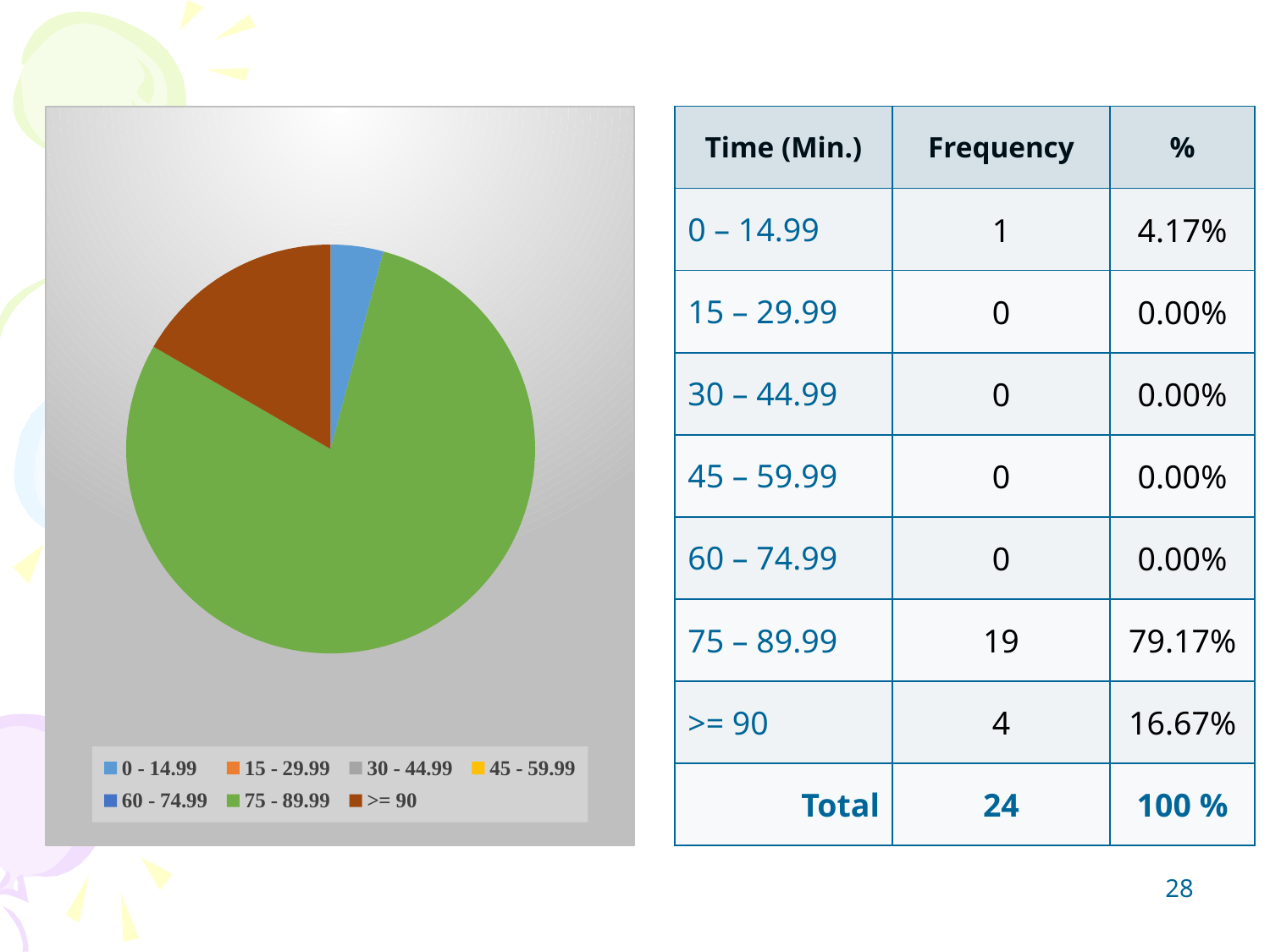
What is the difference in frequency between the 75 – 89.99 and >= 90 categories? 15 How many categories does the pie chart's legend list? 7 Which of the visible slices is the smallest in the pie chart? 0 - 14.99 What colour is the largest slice of the pie chart? green How many time categories in the table have a frequency of 0? 4 According to the table, what percentage share does the 0 – 14.99 category have? 4.17% According to the table, what percentage share does the >= 90 category have? 16.67% Which time category has the largest slice of the pie chart? 75 - 89.99 Is the slice for >= 90 larger or smaller than the slice for 0 - 14.99? larger According to the table, what is the frequency for the 75 – 89.99 time category? 19 What kind of chart is shown on the slide? pie chart What is the total frequency shown in the table? 24